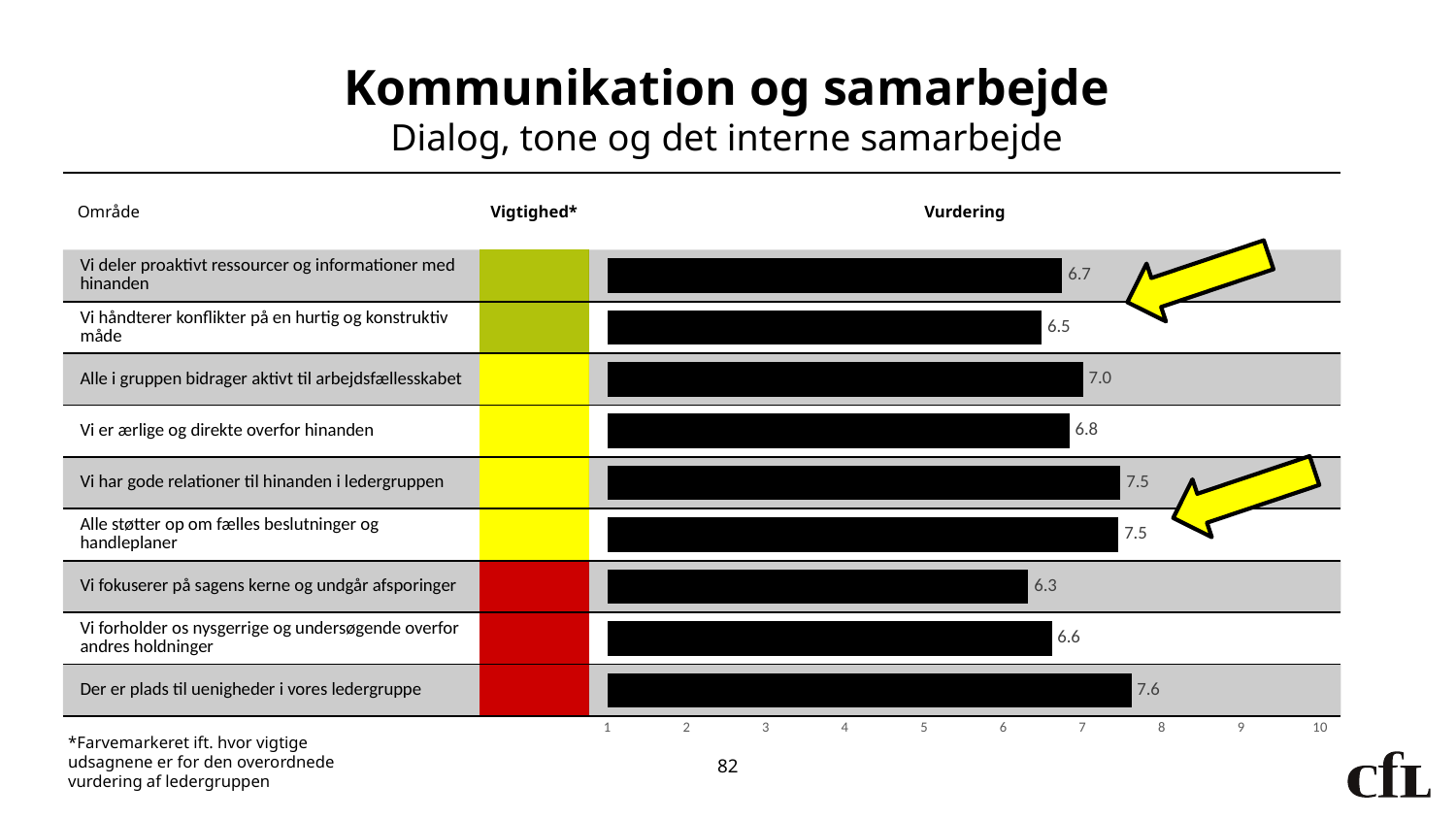
Is the Vurdering value for "Vi har gode relationer til hinanden i ledergruppen" greater or less than 7? greater Which has a higher Vurdering value: "Vi er ærlige og direkte overfor hinanden" or "Vi forholder os nysgerrige og undersøgende overfor andres holdninger"? Vi er ærlige og direkte overfor hinanden What is the Vurdering value for "Vi håndterer konflikter på en hurtig og konstruktiv måde"? 6.5 What is the maximum value shown on the chart's axis? 10 Which statement has the highest Vurdering value? Der er plads til uenigheder i vores ledergruppe What is the difference between the Vurdering values for "Der er plads til uenigheder i vores ledergruppe" and "Vi fokuserer på sagens kerne og undgår afsporinger"? 1.3 How many statements (bars) are shown in the chart? 9 Which statement has the lowest Vurdering value? Vi fokuserer på sagens kerne og undgår afsporinger What is the Vurdering value for "Alle i gruppen bidrager aktivt til arbejdsfællesskabet"? 7.0 What colour is the Vigtighed marker for "Der er plads til uenigheder i vores ledergruppe"? Red What is the Vurdering value for "Vi fokuserer på sagens kerne og undgår afsporinger"? 6.3 What kind of chart is used to show the Vurdering values? Bar chart